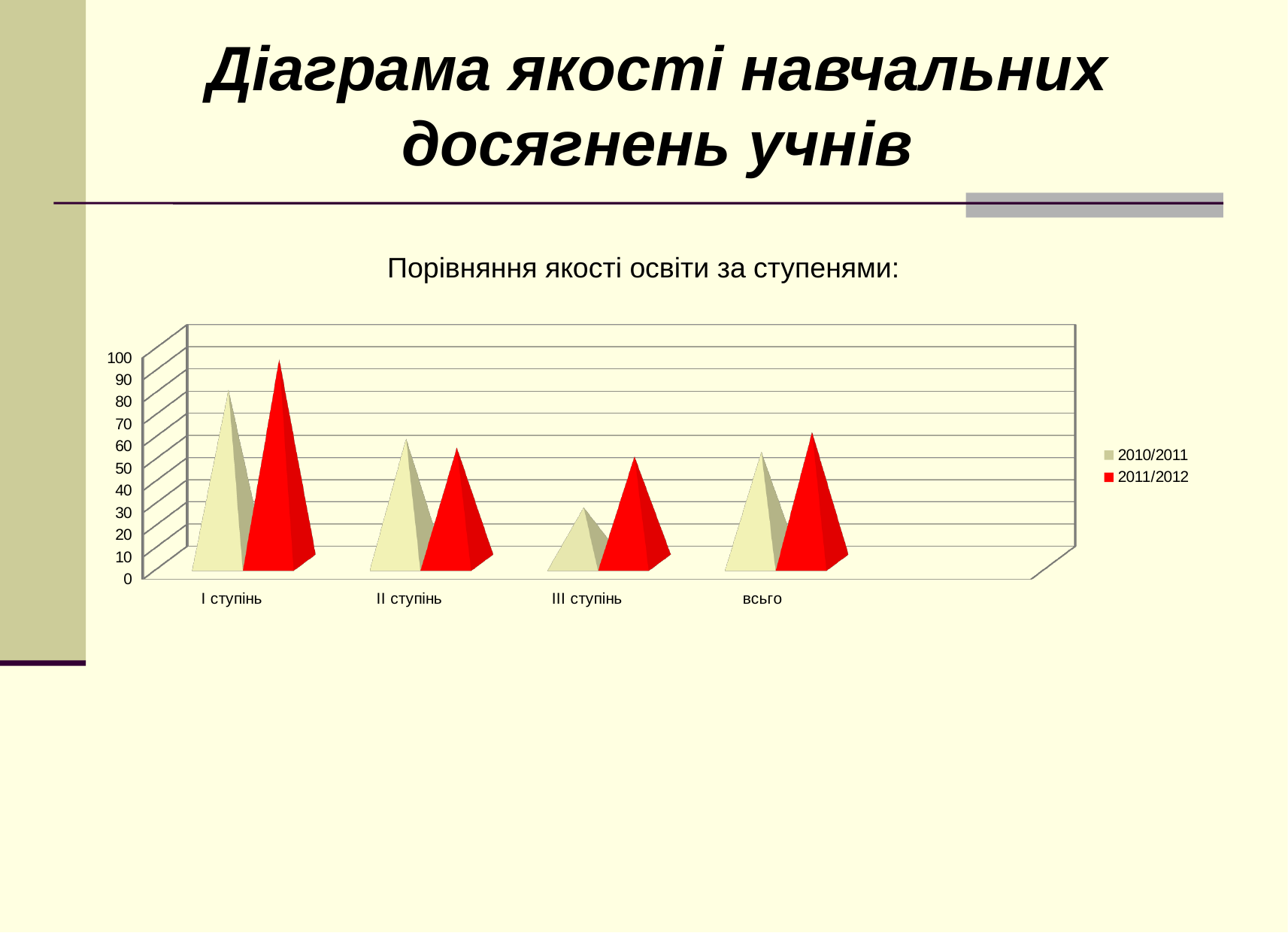
For ІІІ ступінь, which series has the larger value, 2010/2011 or 2011/2012? 2011/2012 Is the 2011/2012 value for І ступінь greater or less than 90? greater Which category has the highest value for the 2011/2012 series? І ступінь What is the title shown above the chart? Порівняння якості освіти за ступенями: Which series is shown in red in the chart? 2011/2012 What kind of chart is shown on the slide? Bar chart Is the 2010/2011 value for ІІІ ступінь greater or less than 40? less How many categories are shown along the x axis of the chart? 4 For І ступінь, which series has the larger value, 2010/2011 or 2011/2012? 2011/2012 Which category has the lowest value for the 2010/2011 series? ІІІ ступінь Is the 2010/2011 value for І ступінь greater or less than 70? greater How many series does the chart legend list? 2